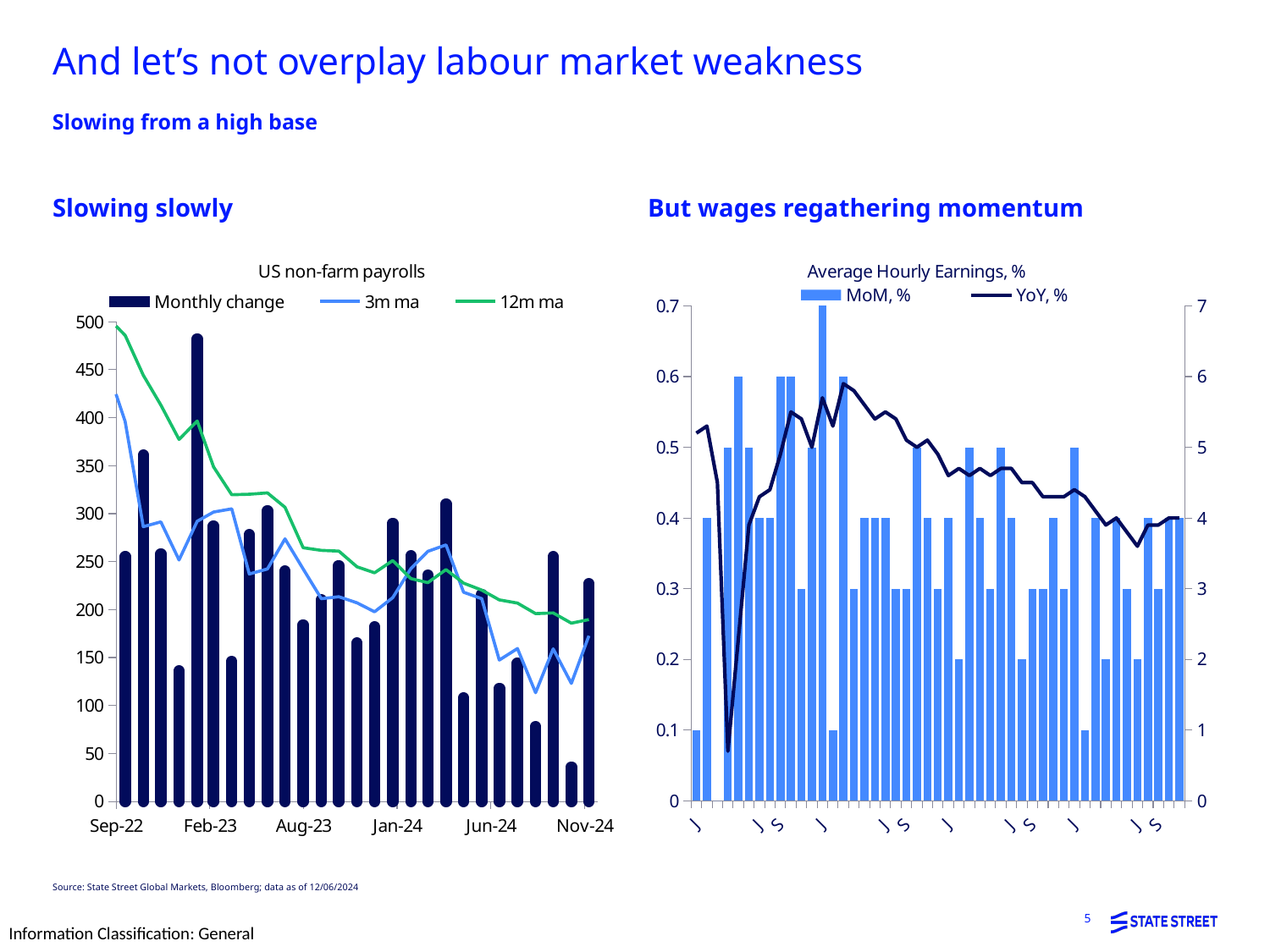
In the 'US non-farm payrolls' chart, is the tallest monthly change bar greater or less than 450? greater In the 'US non-farm payrolls' chart, is the monthly change bar for Sep-22 greater or less than 200? greater In the 'US non-farm payrolls' chart, what colour is the 12m ma line? Green What kind of chart is the 'US non-farm payrolls' chart on the left? A combined bar and line chart How many series does the legend of the 'US non-farm payrolls' chart list? 3 How many series does the legend of the 'Average Hourly Earnings, %' chart list? 2 In the 'US non-farm payrolls' chart, is the 12m ma value at Nov-24 greater or less than 250? less In the 'Average Hourly Earnings, %' chart, what is the highest MoM, % value reached by a bar? 0.7 In the 'Average Hourly Earnings, %' chart, what is the maximum value on the right-hand axis used for YoY, %? 7 In the 'US non-farm payrolls' chart, does the 12m ma line rise or fall from Sep-22 to Nov-24? fall